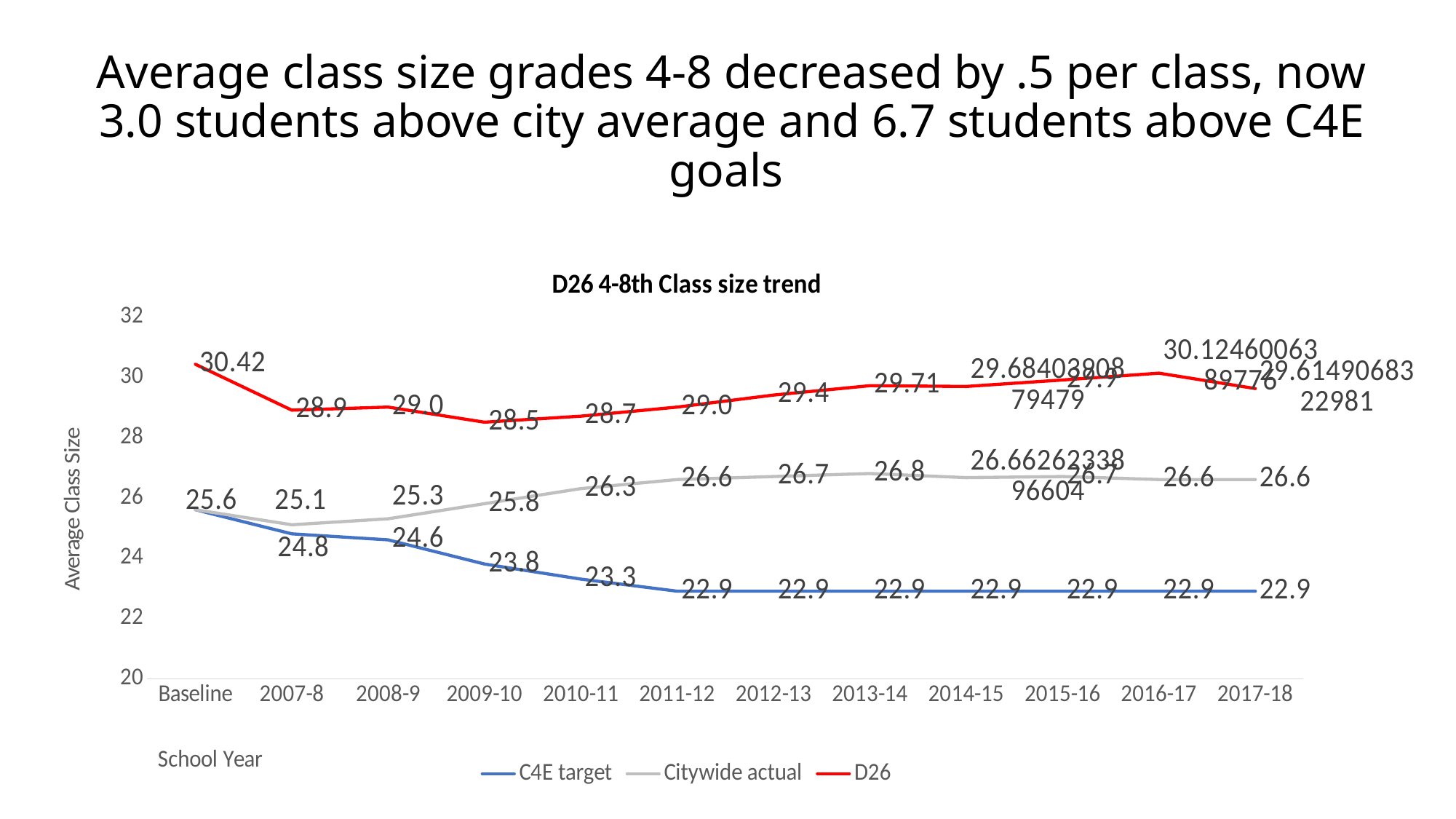
What is the C4E target value for 2009-10? 23.8 Is the D26 value for 2016-17 greater or less than 30? greater What is the D26 value for 2013-14? 29.71 What is the D26 value at Baseline? 30.42 What is the Citywide actual value for 2010-11? 26.3 What is the difference between the D26 value and the Citywide actual value in 2011-12? 2.4 How many series does the legend list? 3 In which school year is the D26 value lowest? 2009-10 How many school years are shown on the x axis? 12 In which school year is the Citywide actual value lowest? 2007-8 Which is larger in 2008-9, the Citywide actual value or the C4E target value? Citywide actual What kind of chart is shown? line chart